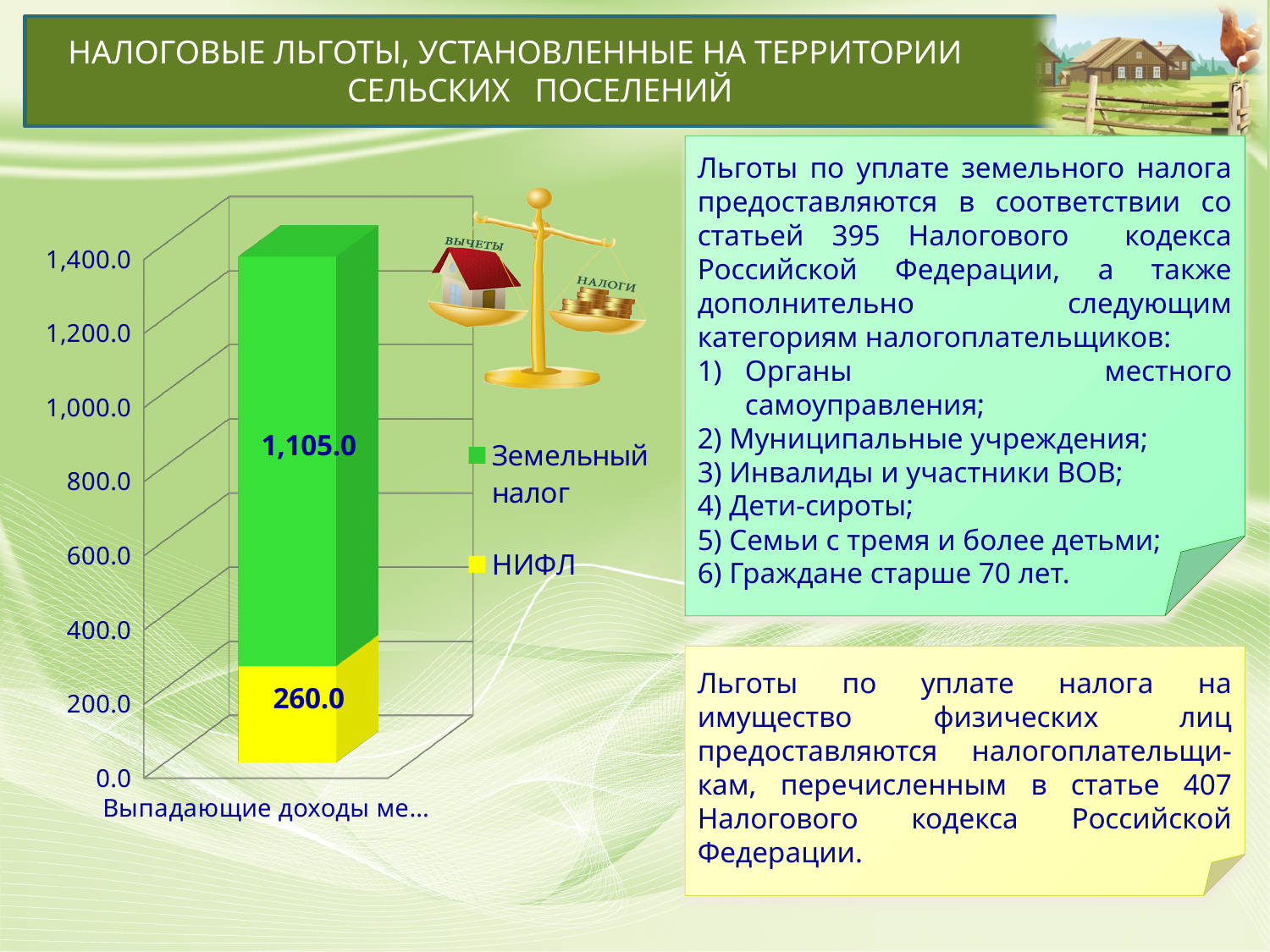
What kind of chart is shown on the slide? Stacked bar chart Which series has the largest value in the chart? Земельный налог What is the value of the Земельный налог segment in the stacked bar? 1,105.0 What is the value of the НИФЛ segment in the stacked bar? 260.0 What is the total of the stacked bar (Земельный налог plus НИФЛ)? 1,365.0 How many bars (categories) are plotted in the chart? 1 Which series has the larger value, Земельный налог or НИФЛ? Земельный налог Which series has the smallest value in the chart? НИФЛ How many series does the chart legend list? 2 What is the difference between the Земельный налог value and the НИФЛ value? 845.0 What colour represents the НИФЛ series in the chart? Yellow What colour represents the Земельный налог series in the chart? Green